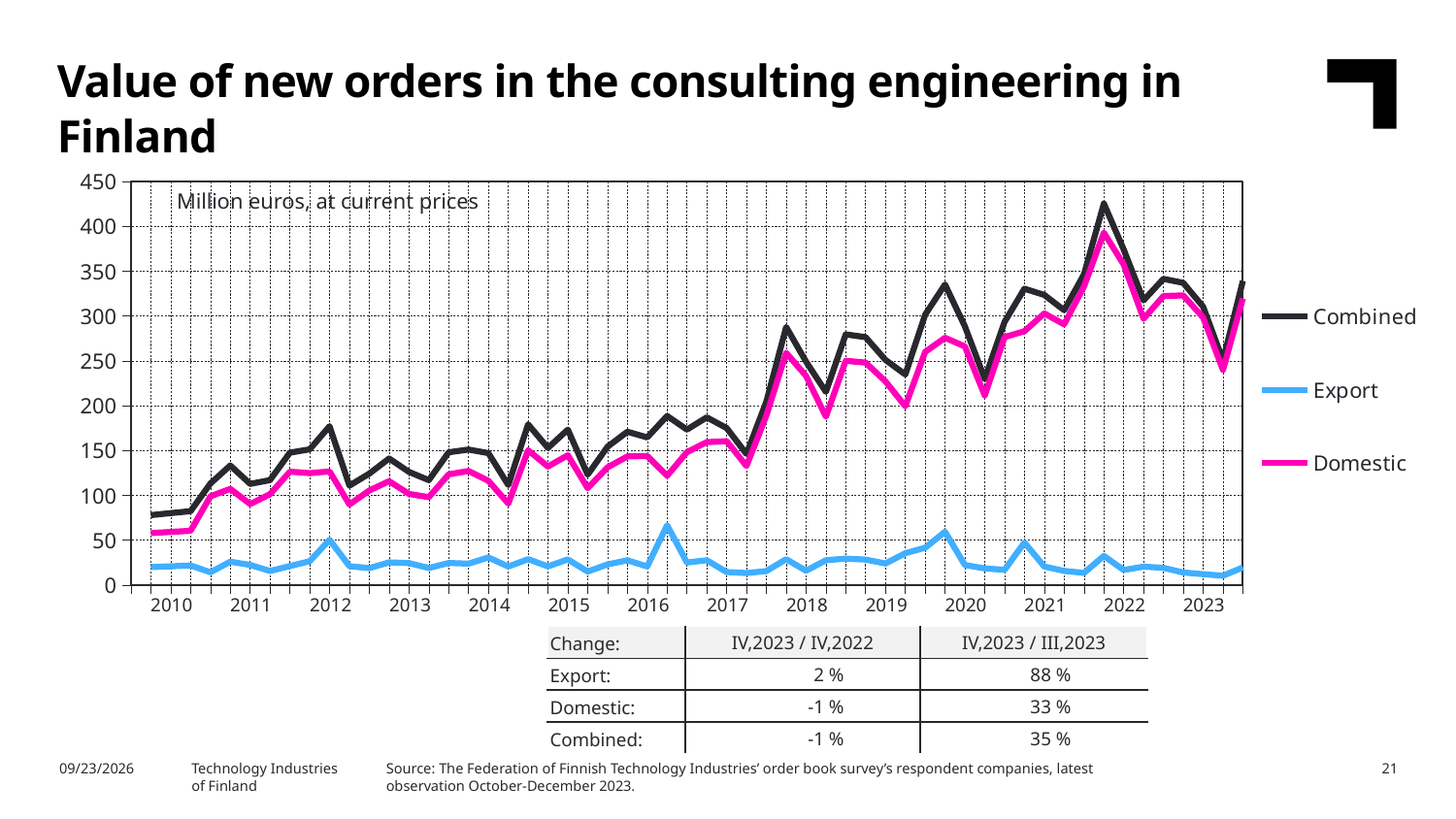
What kind of chart is shown on the slide? line chart Which series has the lowest values throughout the chart? Export What unit is stated in the chart's annotation? Million euros, at current prices Is the Combined value at the start of 2010 greater or less than 100? less Overall, does the Combined series rise or fall from 2010 to 2023? rise Is the peak value of the Combined series greater or less than 400? greater Which series are listed in the legend? Combined, Export, Domestic How many series does the legend list? 3 How many years are labelled on the x axis? 14 Is the peak value of the Domestic series greater or less than 350? greater Which series has the highest values throughout the chart? Combined